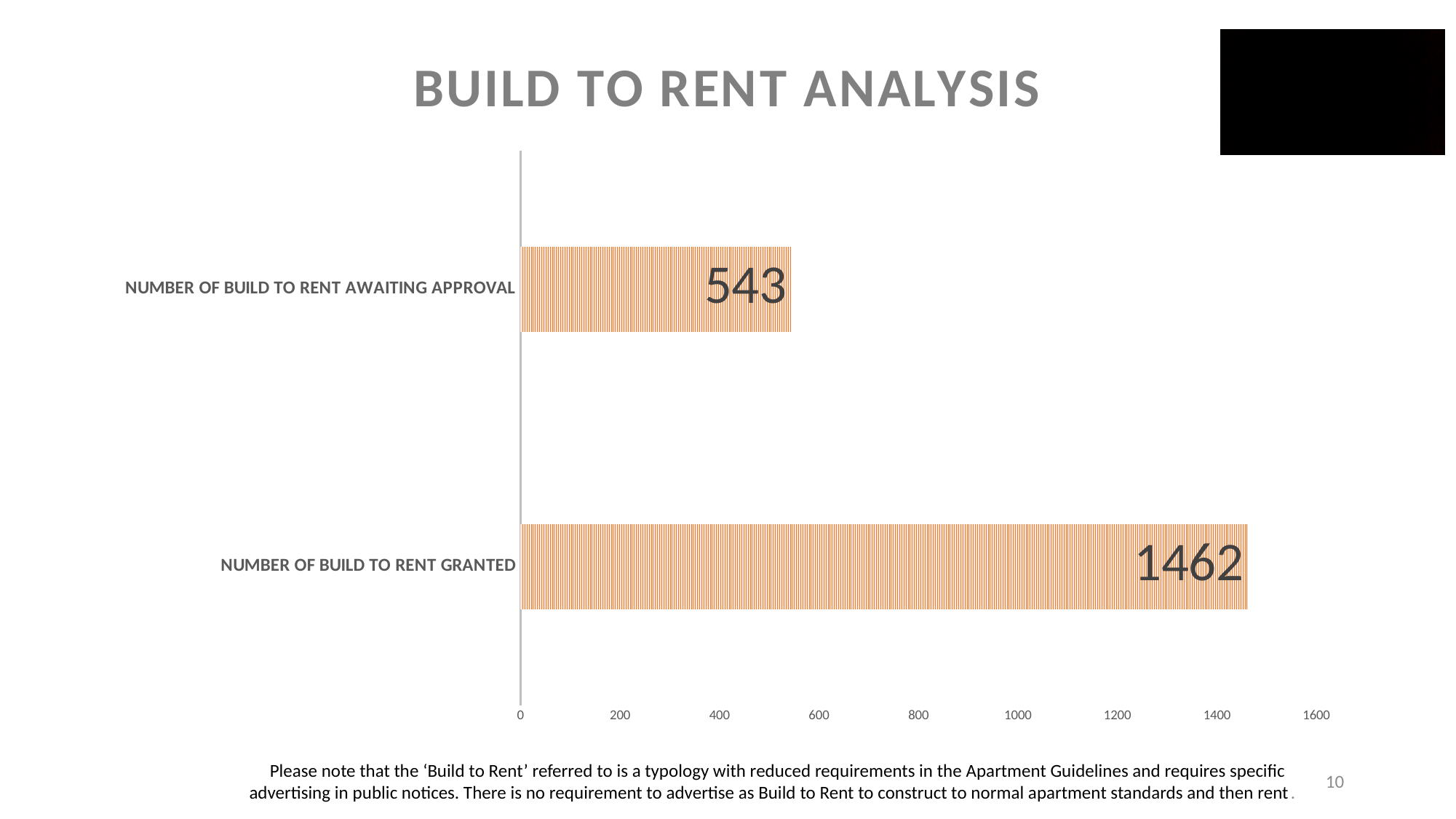
What is the value for Number of Build to Rent Awaiting Approval? 543 Is the value for Number of Build to Rent Awaiting Approval greater or less than 600? less What is the maximum value shown on the horizontal axis? 1600 Which category has the lowest value? Number of Build to Rent Awaiting Approval What kind of chart is shown on the slide? Bar chart What is the title of the slide? Build to Rent Analysis Is the value for Number of Build to Rent Granted greater or less than 1400? greater Which is larger: Number of Build to Rent Granted or Number of Build to Rent Awaiting Approval? Number of Build to Rent Granted Which category has the highest value? Number of Build to Rent Granted What is the difference between the number of Build to Rent Granted and the number Awaiting Approval? 919 What is the value for Number of Build to Rent Granted? 1462 How many categories are shown in the chart? 2